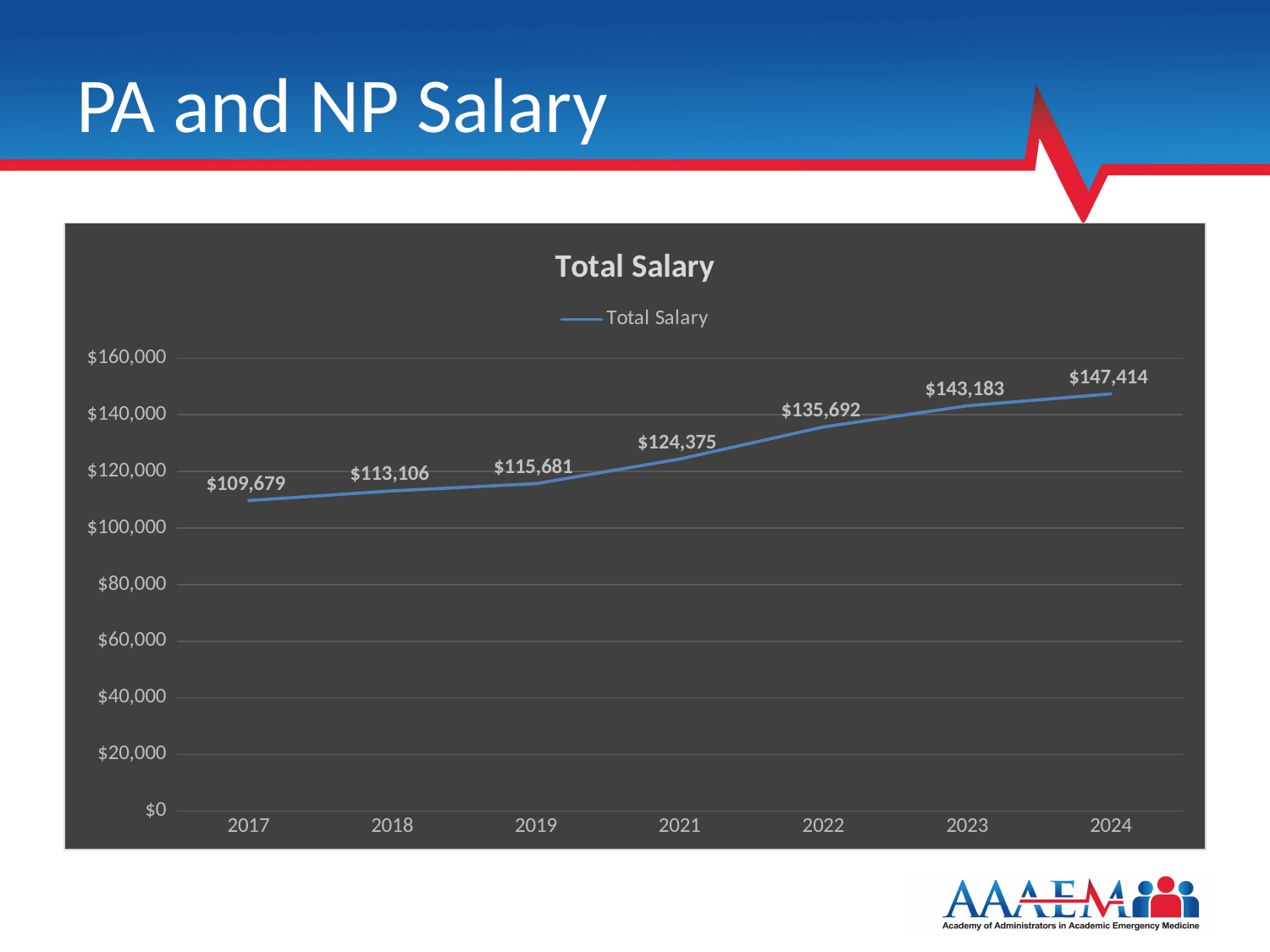
Which year has the lowest Total Salary? 2017 What is the Total Salary value for 2017? $109,679 What is the difference between the Total Salary in 2024 and in 2017? $37,735 Which year has the highest Total Salary? 2024 Does the Total Salary rise or fall from 2017 to 2024? Rise What is the Total Salary value for 2024? $147,414 Is the Total Salary for 2022 greater or less than $120,000? greater What kind of chart is shown on the slide? Line chart What is the difference between the Total Salary in 2022 and in 2021? $11,317 How many years are plotted on the x axis? 7 Which is larger, the Total Salary in 2019 or in 2023? 2023 What is the Total Salary value for 2021? $124,375